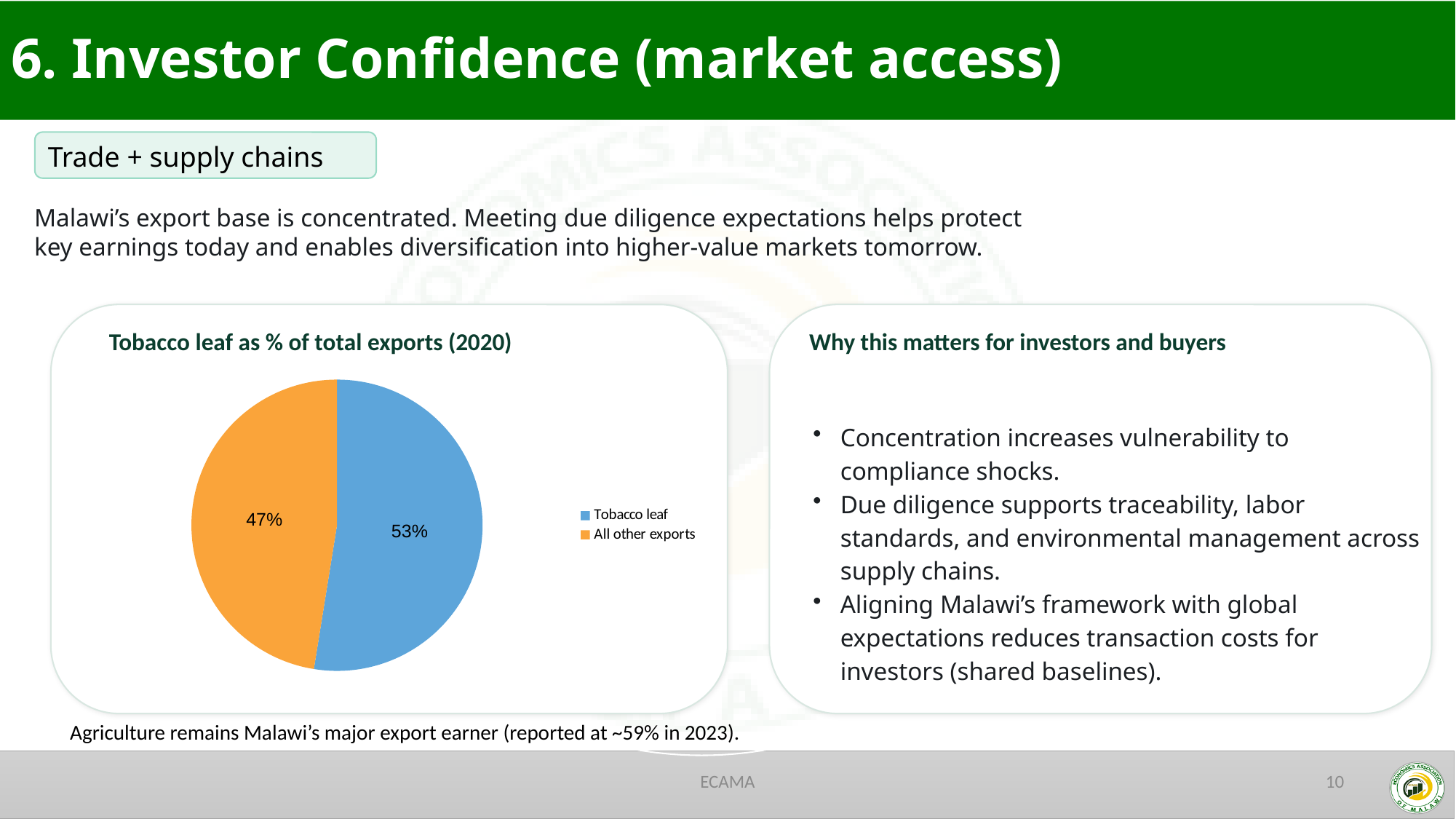
Is the share for Tobacco leaf greater or less than 50%? greater What is the difference in percentage points between the Tobacco leaf slice and the All other exports slice? 6 percentage points What type of chart is shown on the slide? pie chart Which slice of the pie chart is the largest? Tobacco leaf Which slice of the pie chart is the smallest? All other exports Which is larger in the pie chart, Tobacco leaf or All other exports? Tobacco leaf What is the title of the chart? Tobacco leaf as % of total exports (2020) How many slices does the pie chart have? 2 How many entries does the chart legend list? 2 What share of total exports does Tobacco leaf account for in the pie chart? 53% What colour is the Tobacco leaf slice in the pie chart? blue What share of total exports does All other exports account for in the pie chart? 47%